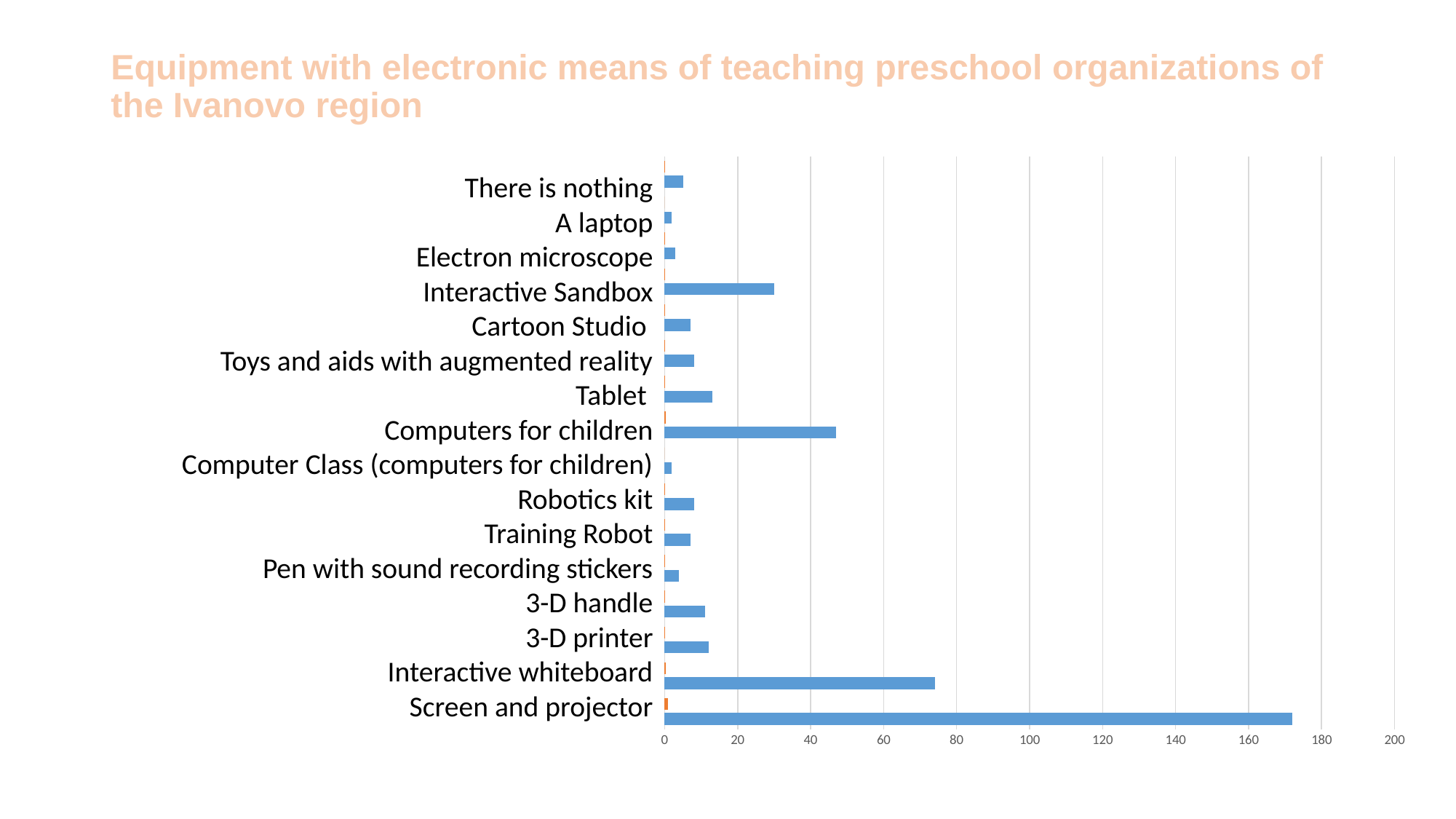
Is the value for Interactive Sandbox greater or less than 40? less Is the value for Computers for children greater or less than 40? greater Which category has the highest value on the chart? Screen and projector Is the value for Tablet greater or less than 20? less Which has the larger value, Interactive whiteboard or Computers for children? Interactive whiteboard How many categories are plotted on the chart? 16 What kind of chart is shown on the slide? bar chart Which has the larger value, Interactive Sandbox or Tablet? Interactive Sandbox What is the title of the chart on the slide? Equipment with electronic means of teaching preschool organizations of the Ivanovo region